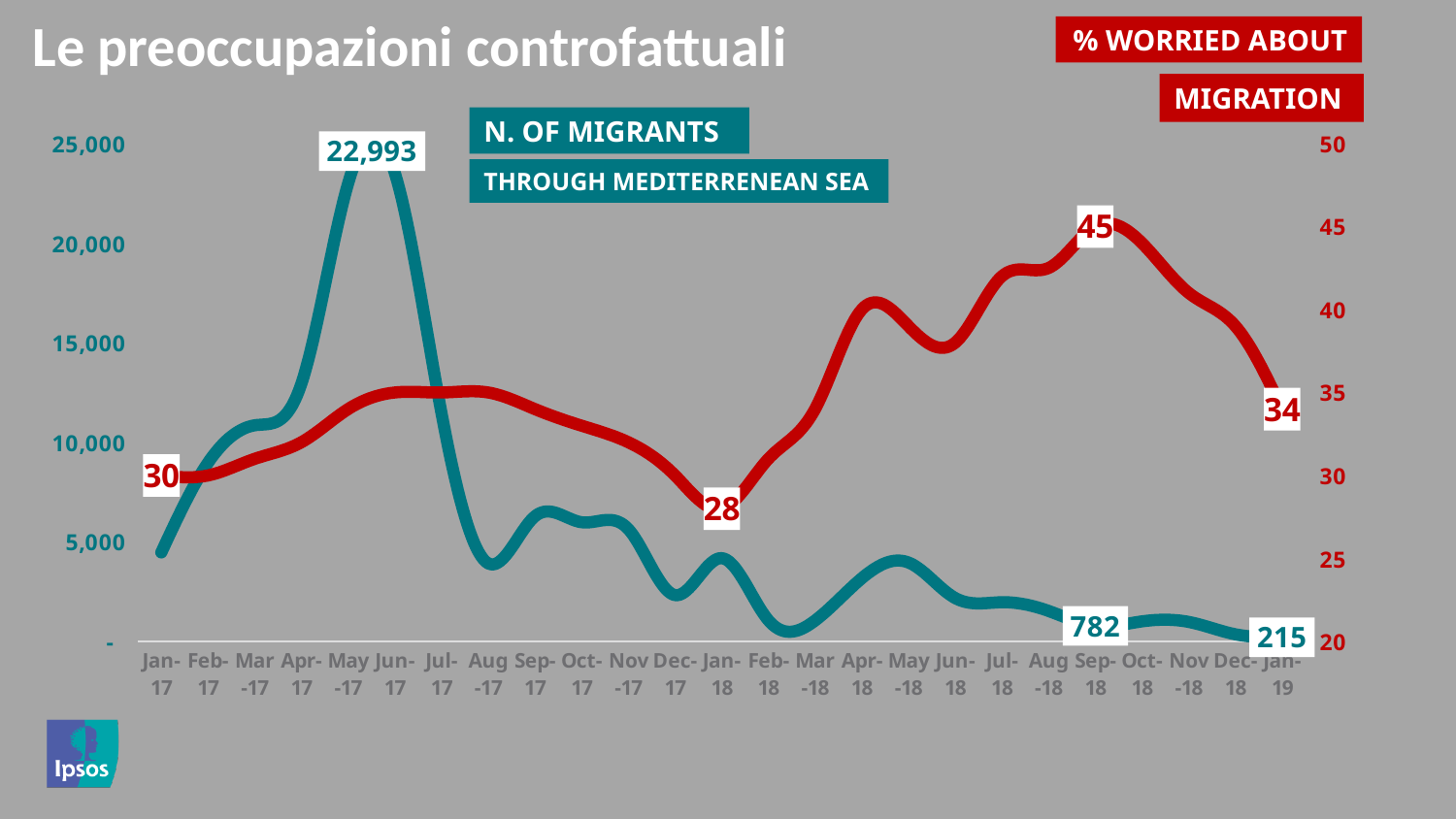
What is the labelled value of the N. of migrants line at Sep-18? 782 What is the labelled % worried about migration at Jan-17? 30 What kind of chart is shown on the slide? line chart What is the labelled value of the N. of migrants line at Jan-19? 215 Which series is drawn in red? % worried about migration What is the labelled % worried about migration at Jan-19? 34 Is the N. of migrants value at Jan-17 greater or less than 5,000? less What is the difference between the N. of migrants labelled at Sep-18 and at Jan-19? 567 By how much did the % worried about migration fall from its labelled peak of 45 to the Jan-19 value? 11 What is the peak value labelled on the N. of migrants through Mediterranean Sea line? 22,993 What is the highest labelled value on the % worried about migration line? 45 What is the labelled % worried about migration at Jan-18? 28